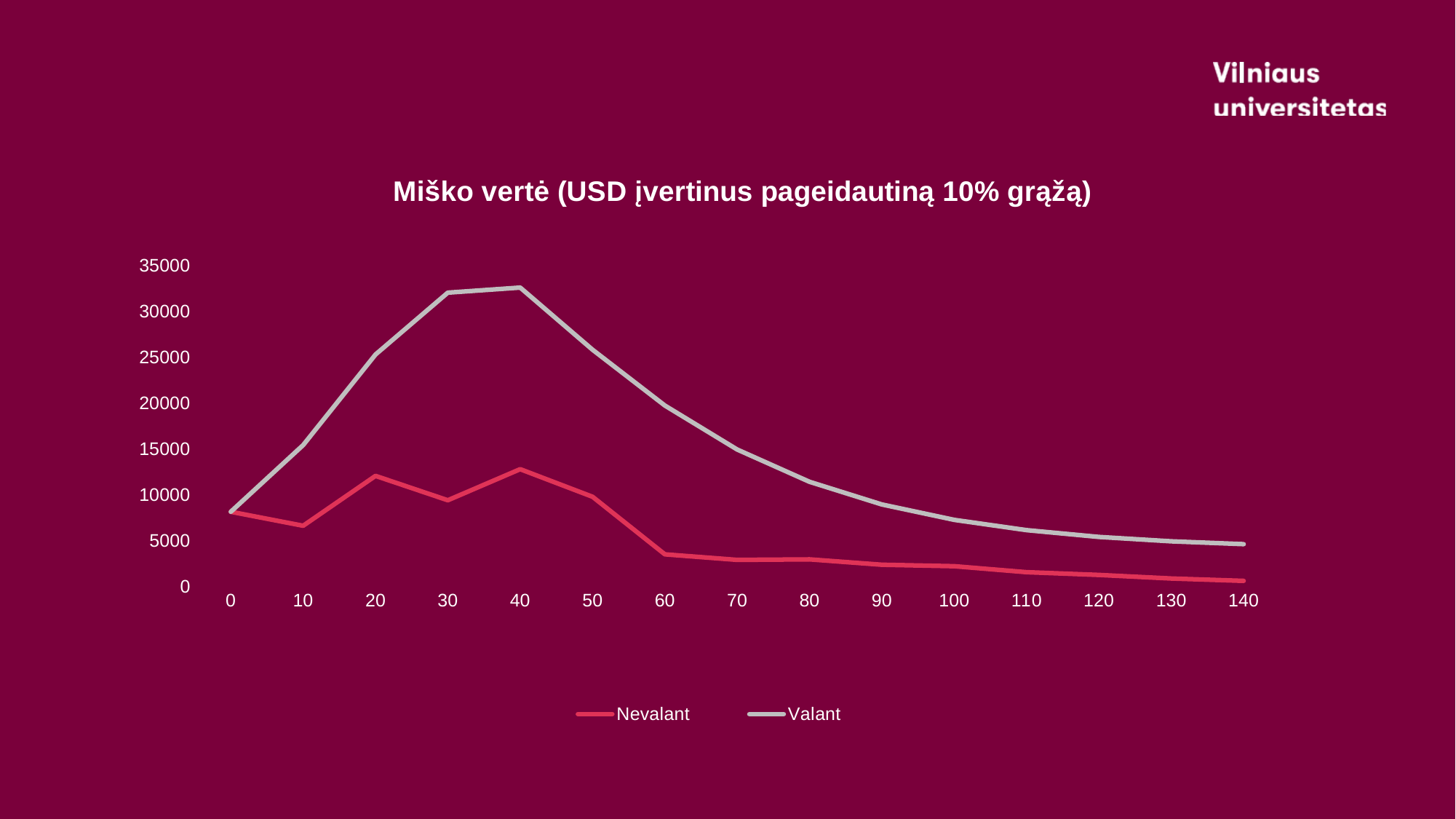
What kind of chart is shown on the slide? line chart Is the value for Valant at 40 greater or less than 30000? greater Which series is drawn in grey? Valant Is the value for Nevalant at 60 greater or less than 5000? less At x = 40, which series has the larger value, Nevalant or Valant? Valant What is the title of the chart? Miško vertė (USD įvertinus pageidautiną 10% grąžą) How many points are plotted along the x axis for each series? 15 At which x value does the Valant series reach its lowest point? 140 Do the values for Valant rise or fall from 40 to 140 along the x axis? fall How many series does the legend list? 2 Is the value for Nevalant at 40 greater or less than 10000? greater